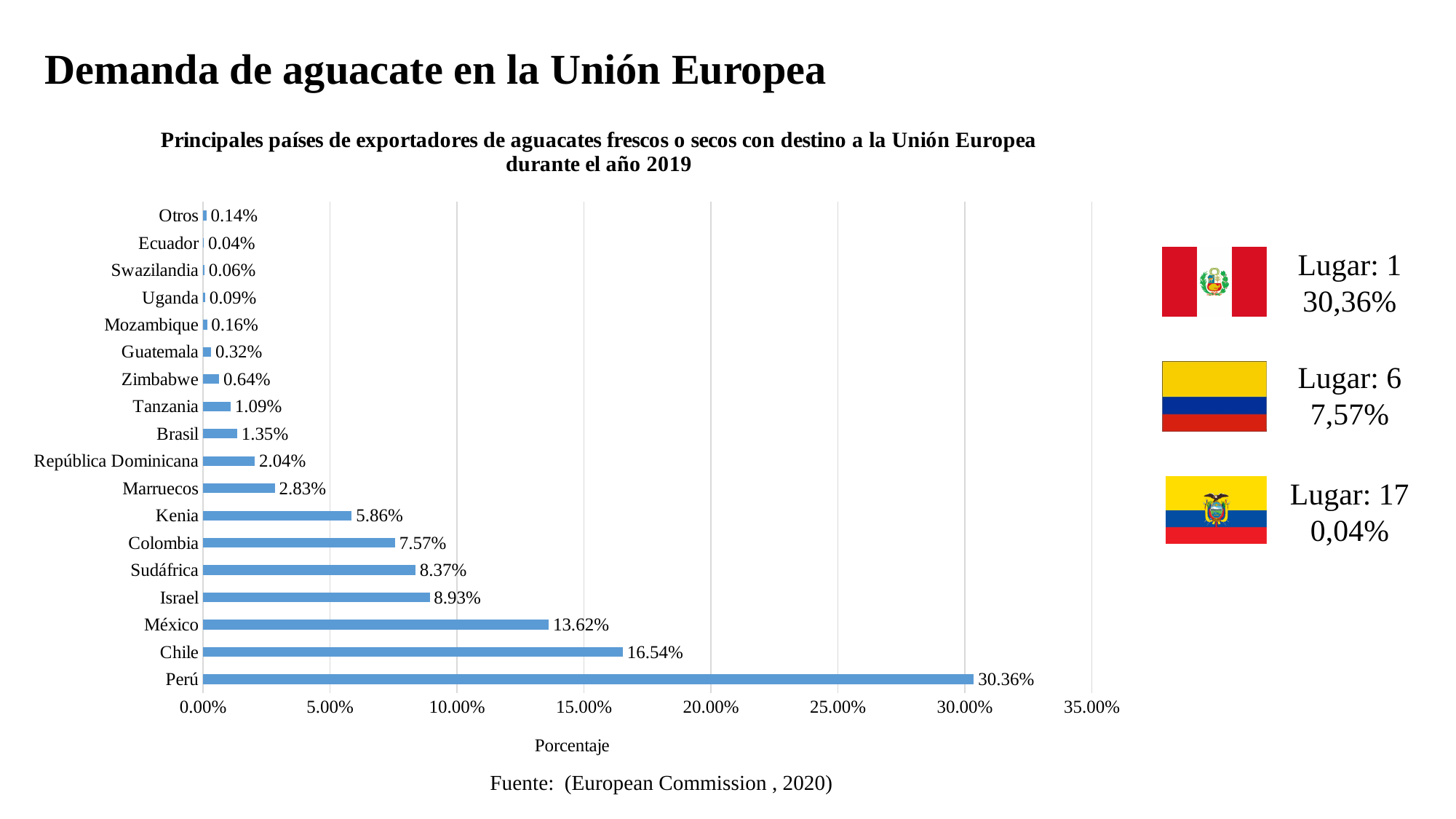
What is the value for Perú? 30.36% How many categories are shown on the chart? 18 What kind of chart is shown? bar chart Which country has the highest value? Perú What is the label of the horizontal axis? Porcentaje What is the value for Colombia? 7.57% What is the value for Marruecos? 2.83% What is the difference between the values for Chile and México? 2.92% Which category has the lowest value? Ecuador Which is larger, the value for Israel or the value for Sudáfrica? Israel What is the value for Ecuador? 0.04% Is the value for Kenia greater or less than 5.00%? greater